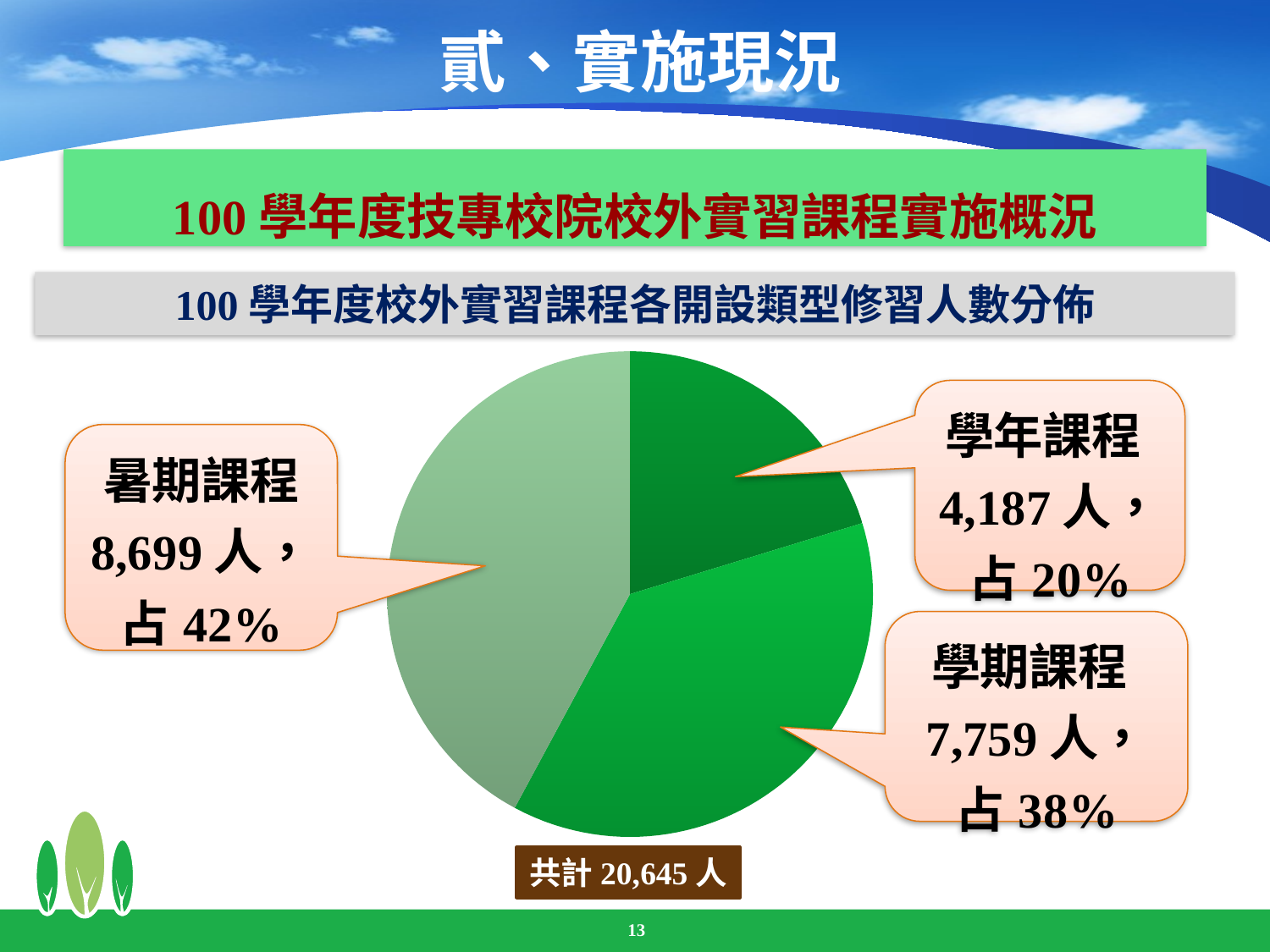
Which course type has the largest share of the pie chart? 暑期課程 What is the difference in number of people between 暑期課程 and 學期課程? 940 人 Which has more people, 學期課程 or 學年課程? 學期課程 What percentage share does 學年課程 have in the pie chart? 20% What type of chart is shown on the slide? pie chart How many slices does the pie chart have? 3 How many people took 暑期課程 according to the pie chart? 8,699 人 How many people took 學期課程 according to the pie chart? 7,759 人 What percentage share does 學期課程 have in the pie chart? 38% What is the total number of people shown below the pie chart? 20,645 人 Which course type has the smallest share of the pie chart? 學年課程 How many people took 學年課程 according to the pie chart? 4,187 人